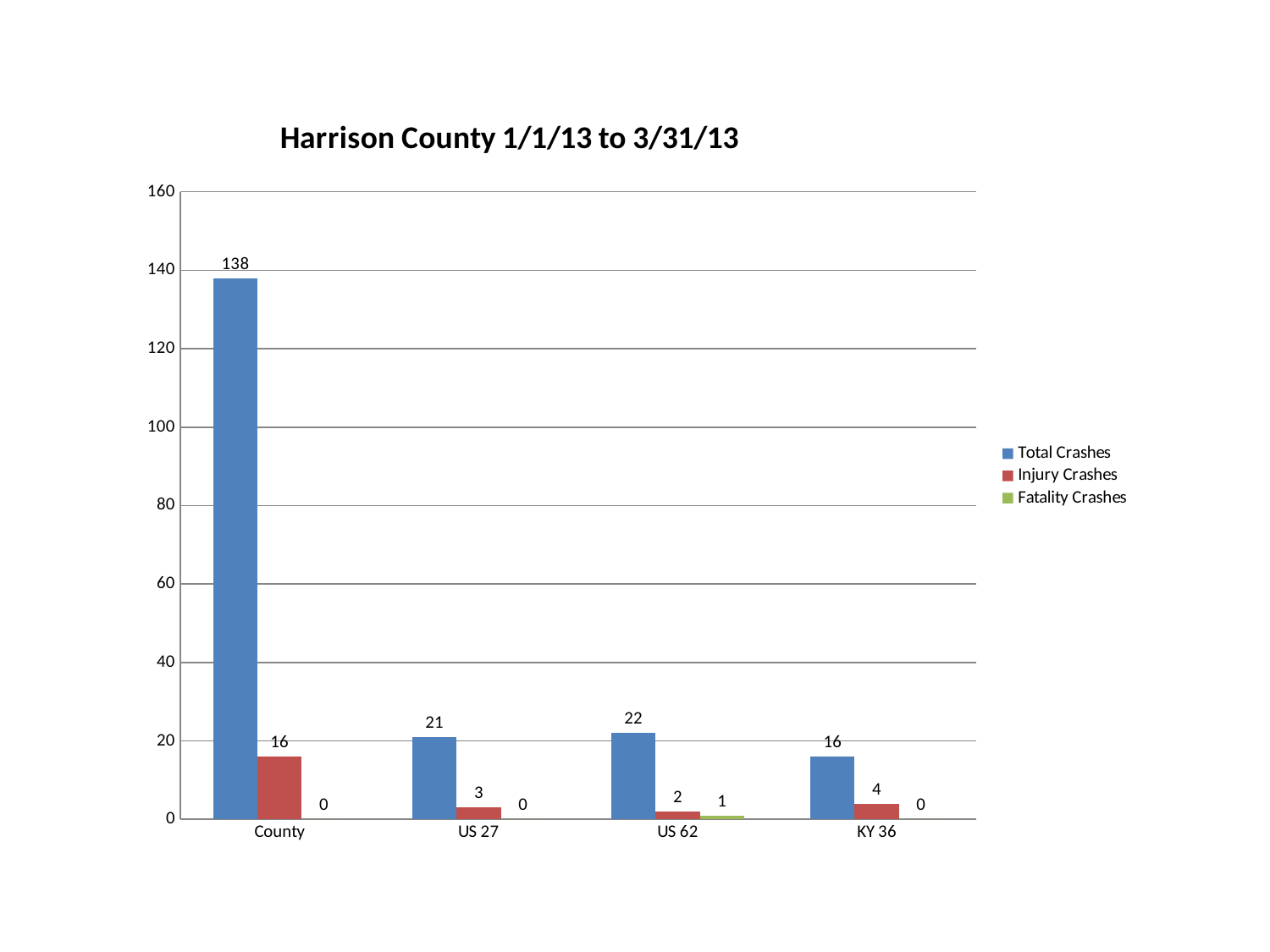
What is the title of the chart? Harrison County 1/1/13 to 3/31/13 Which is larger, Injury Crashes for US 27 or Injury Crashes for KY 36? KY 36 How many series does the legend list? 3 Which category has the lowest Total Crashes value? KY 36 What is the value of Fatality Crashes for US 62? 1 What is the value of Total Crashes for County? 138 What is the difference between Total Crashes for County and Total Crashes for US 62? 116 What kind of chart is shown on the slide? bar chart What is the value of Injury Crashes for KY 36? 4 Which category has the highest Total Crashes value? County How many categories are shown on the x axis? 4 Is the value of Total Crashes for US 27 greater or less than 40? less